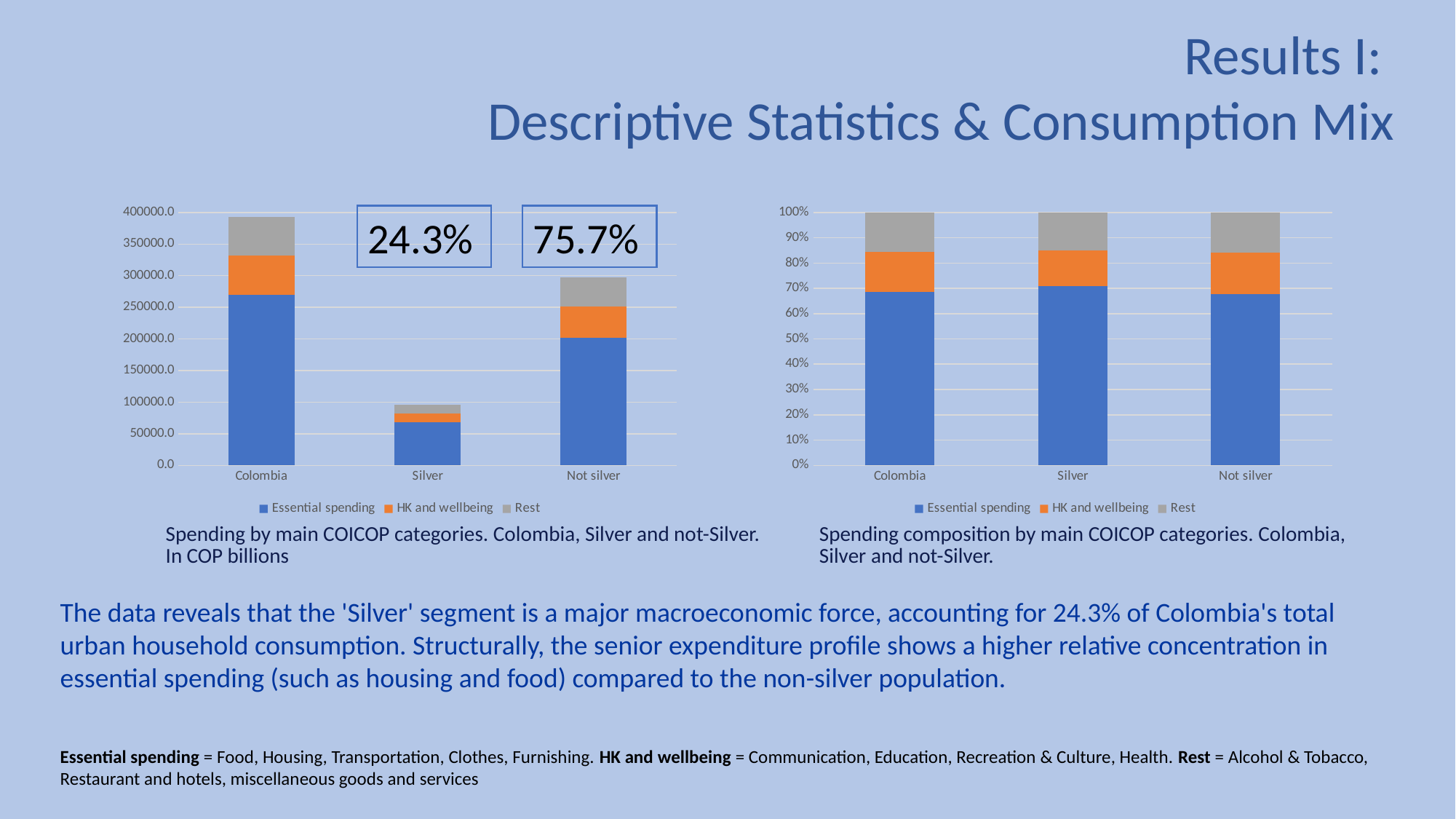
In the left chart, 'Spending by main COICOP categories', is the total bar for Colombia greater or less than 350000.0? greater In the left chart, 'Spending by main COICOP categories', is the total bar for Silver greater or less than 100000.0? less In the left chart, 'Spending by main COICOP categories', which category has the lowest total spending? Silver In the left chart, 'Spending by main COICOP categories', which has the larger total spending, Silver or Not silver? Not silver In the left chart, 'Spending by main COICOP categories', which category has the highest total spending? Colombia In the right chart, 'Spending composition by main COICOP categories', is the Rest share for Silver greater or less than 20%? less How many categories are shown on the x axis of the left chart, 'Spending by main COICOP categories'? 3 How many series does the legend of the right chart, 'Spending composition by main COICOP categories', list? 3 What percentage is shown in the box above the Silver bar in the left chart? 24.3% Which series is shown in orange in the left chart, 'Spending by main COICOP categories'? HK and wellbeing What kind of chart is the left chart, 'Spending by main COICOP categories'? Stacked bar chart